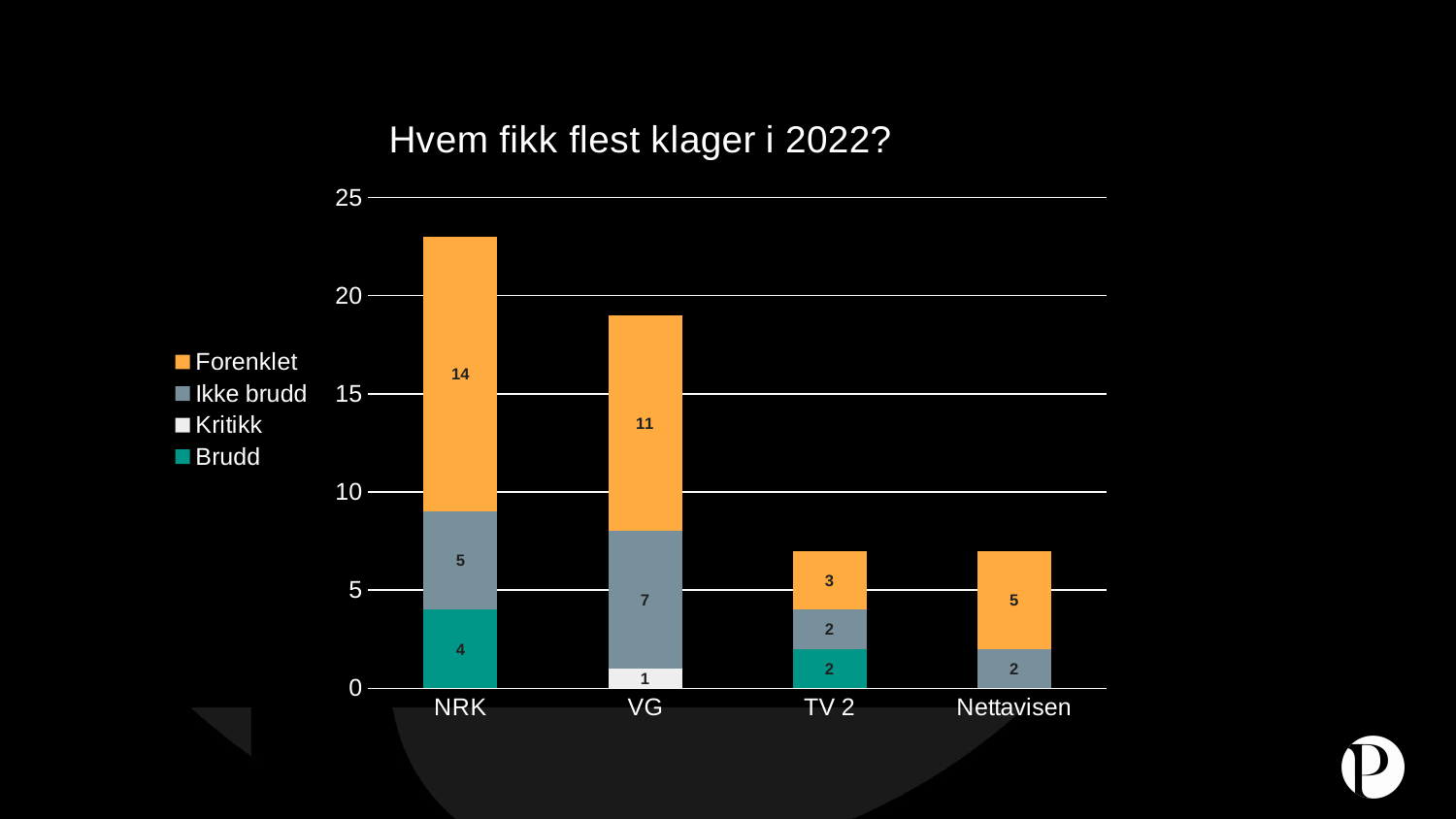
What is the Brudd value for TV 2? 2 Which category has the highest total stacked bar? NRK What is the Ikke brudd value for VG? 7 What is the Forenklet value for NRK? 14 What is the title of the chart? Hvem fikk flest klager i 2022? What is the total of the stacked bar for NRK? 23 What kind of chart is shown on the slide? Stacked bar chart What is the difference between the Forenklet values for NRK and VG? 3 What is the total of the stacked bar for VG? 19 How many series does the legend list? 4 How many categories are shown on the x axis? 4 What is the Kritikk value for VG? 1